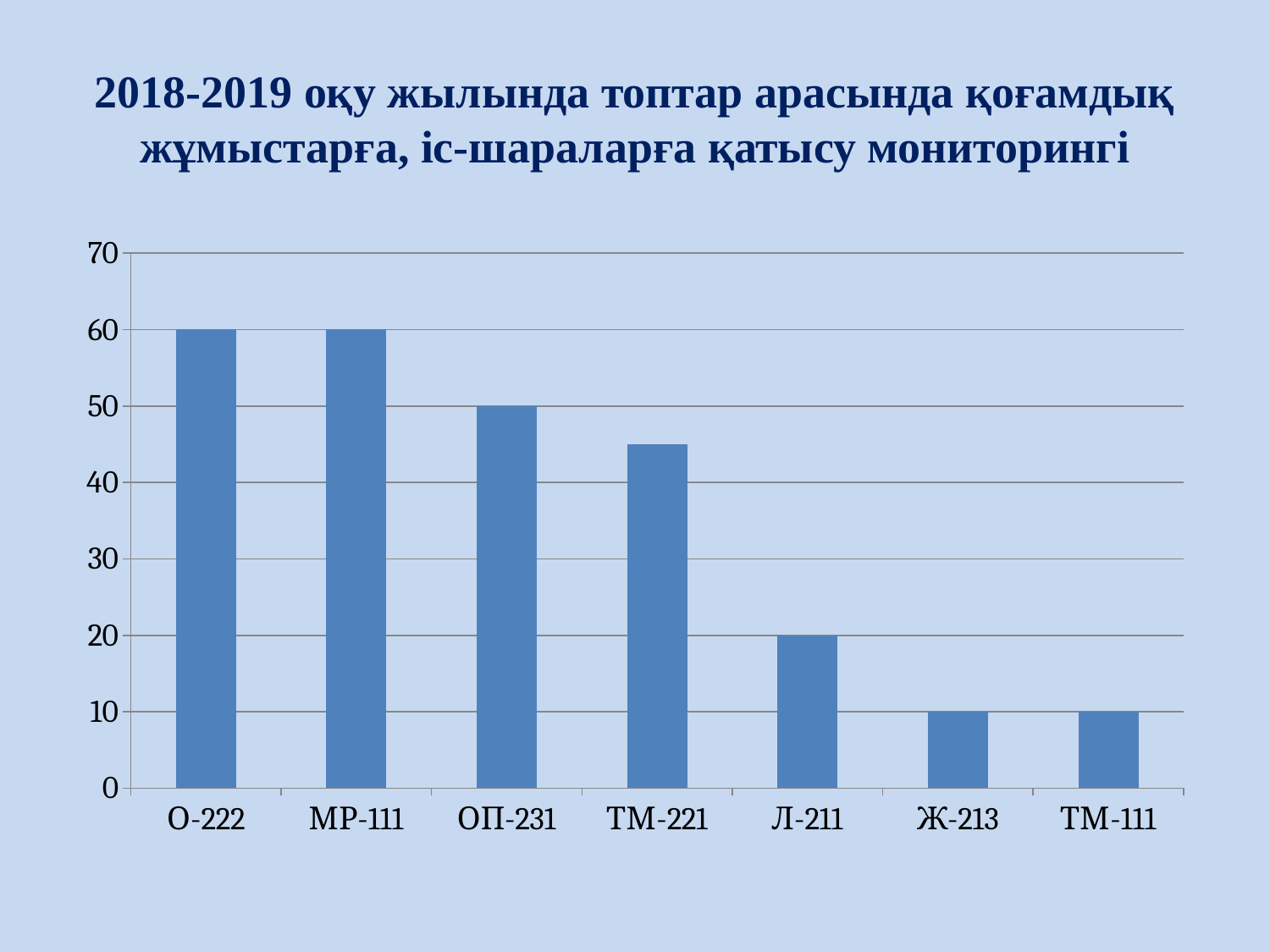
What is the highest value shown on the vertical axis of the chart? 70 What is the value for Ж-213? 10 Is the value for ТМ-221 greater or less than 50? less What is the value for ОП-231? 50 Do the values generally rise or fall from left to right along the x axis? fall What is the difference between the values for МР-111 and ТМ-111? 50 What is the value for Л-211? 20 Is the value for ТМ-221 greater or less than 40? greater How many groups (categories) are shown on the x axis of the chart? 7 What kind of chart is shown on the slide? bar chart What is the value for О-222? 60 Which is larger, the value for ОП-231 or the value for Л-211? ОП-231